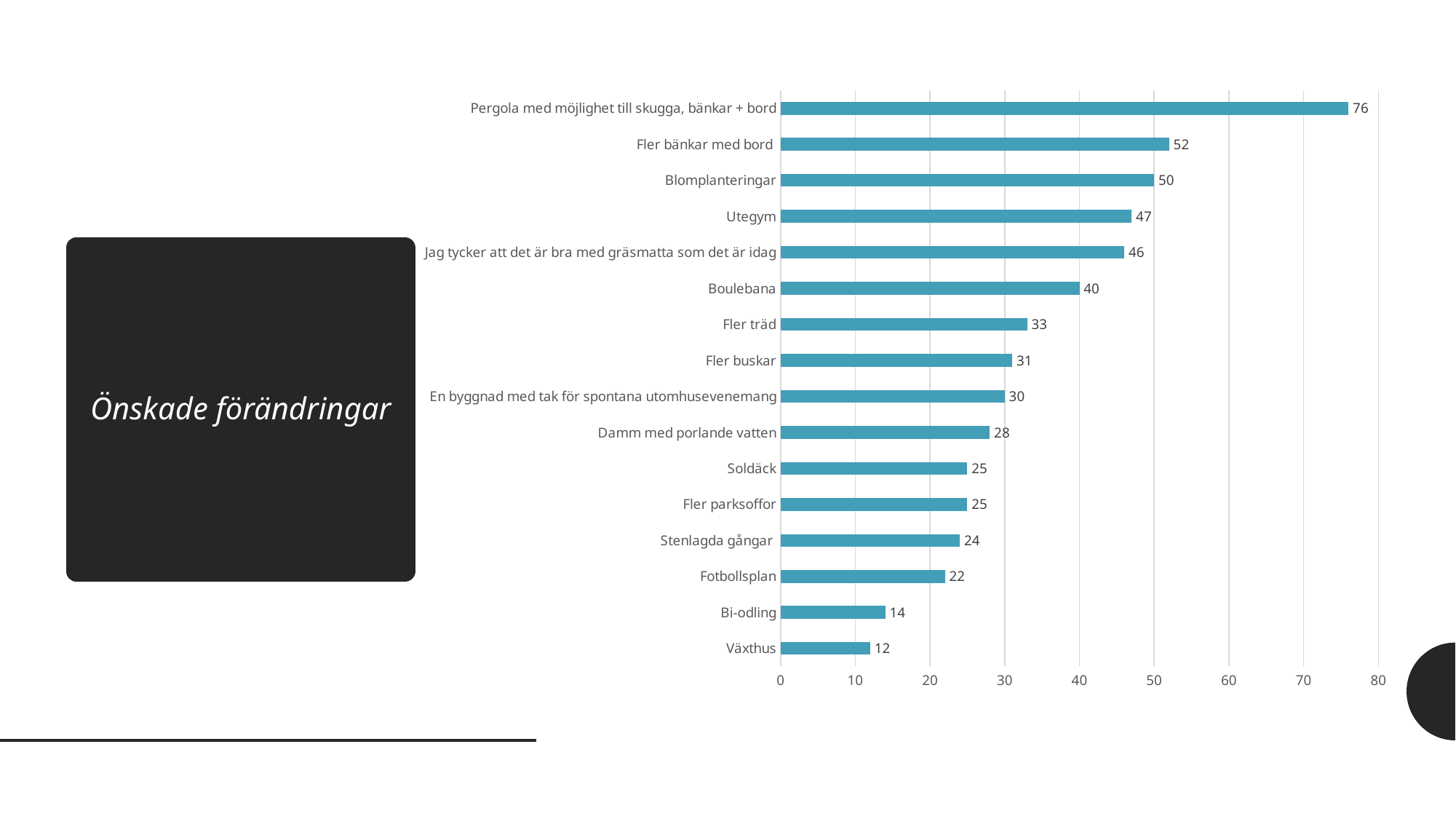
What is the difference between the values for Fler bänkar med bord and Blomplanteringar? 2 What is the value for Damm med porlande vatten? 28 Which is larger, the value for Fotbollsplan or the value for Stenlagda gångar? Stenlagda gångar What is the value for Utegym? 47 What is the difference between the values for Fler träd and Bi-odling? 19 Is the value for Jag tycker att det är bra med gräsmatta som det är idag greater or less than 40? greater What is the title shown in the dark box on the slide? Önskade förändringar What kind of chart is shown on the slide? Bar chart What is the value for Boulebana? 40 How many categories are shown in the chart? 16 Which category has the highest value? Pergola med möjlighet till skugga, bänkar + bord Which category has the lowest value? Växthus